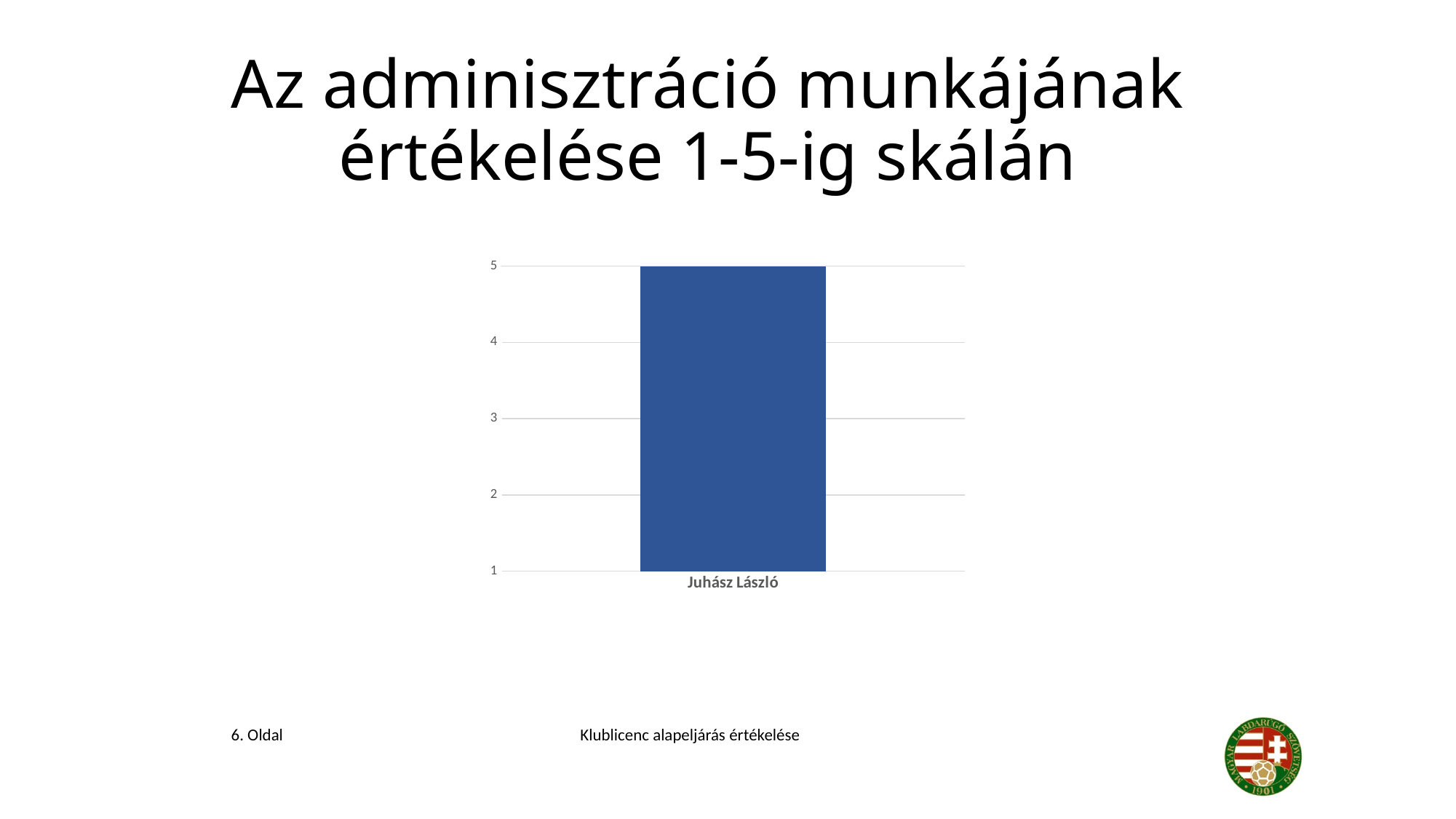
How many categories are plotted in the chart? 1 What is the value for Juhász László in the chart? 5 What kind of chart is shown on the slide? bar chart What is the highest value shown on the vertical axis of the chart? 5 Is the value for Juhász László greater or less than 3? greater What is the label of the single category on the x axis? Juhász László Is the value for Juhász László greater or less than 4? greater